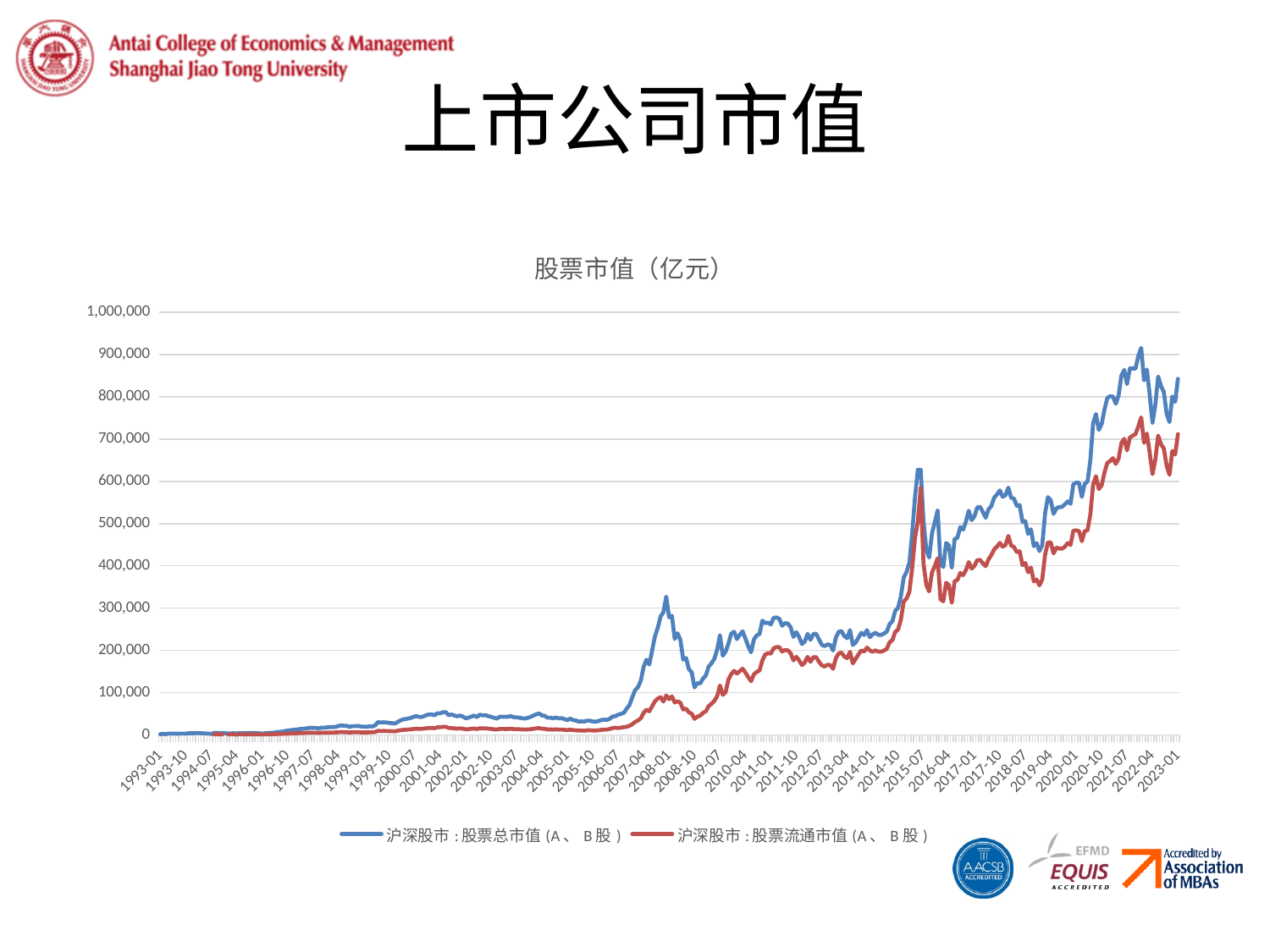
What is the title of the chart? 股票市值（亿元） What type of chart is shown on the slide? line chart Which colour is used for the 沪深股市:股票总市值(A、B股) series? blue How many series does the legend list? 2 Is the value of 沪深股市:股票总市值(A、B股) around 2019-01 greater or less than 500,000? less Is the peak value of 沪深股市:股票总市值(A、B股) around 2008-01 greater or less than 300,000? greater Is the value of 沪深股市:股票总市值(A、B股) at 2023-01 greater or less than 800,000? greater Overall, do the values of 沪深股市:股票总市值(A、B股) rise or fall from 1993-01 to 2023-01? rise At 2023-01, which series has the larger value, 股票总市值 or 股票流通市值? 股票总市值 Which series reaches the highest value on the chart? 沪深股市:股票总市值(A、B股)